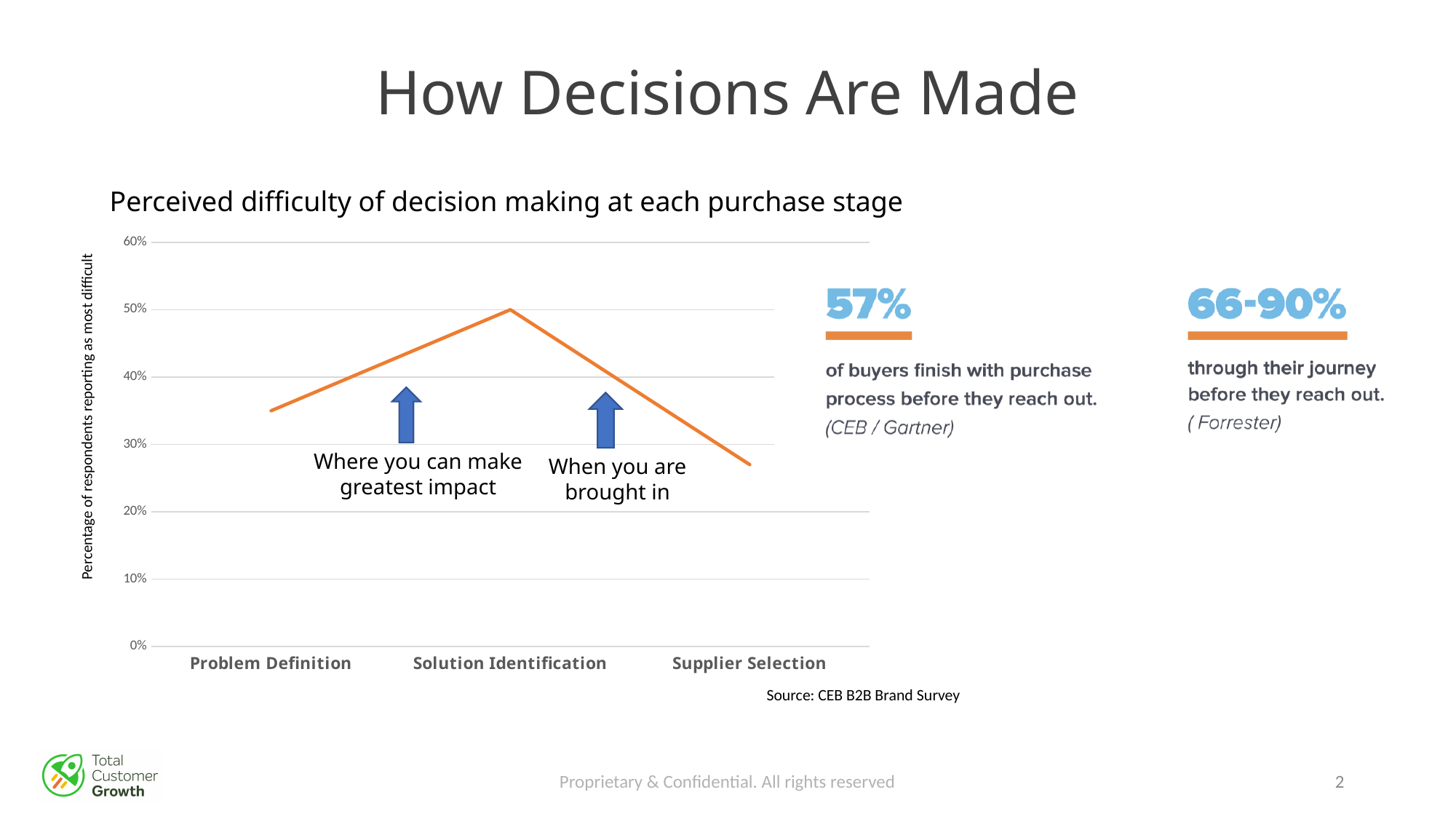
Which has a higher value in the chart, Problem Definition or Supplier Selection? Problem Definition Which purchase stage has the highest perceived difficulty in the chart? Solution Identification Is the value for Solution Identification greater or less than 40%? greater Is the value for Supplier Selection greater or less than 30%? less What kind of chart is shown on the slide? Line chart What is the label on the chart's vertical axis? Percentage of respondents reporting as most difficult Is the value for Problem Definition greater or less than 30%? greater How many purchase stages are plotted along the x axis of the chart? 3 What is the title of the chart? Perceived difficulty of decision making at each purchase stage Which purchase stage has the lowest perceived difficulty in the chart? Supplier Selection How does the line move from Problem Definition to Supplier Selection? It rises, then falls